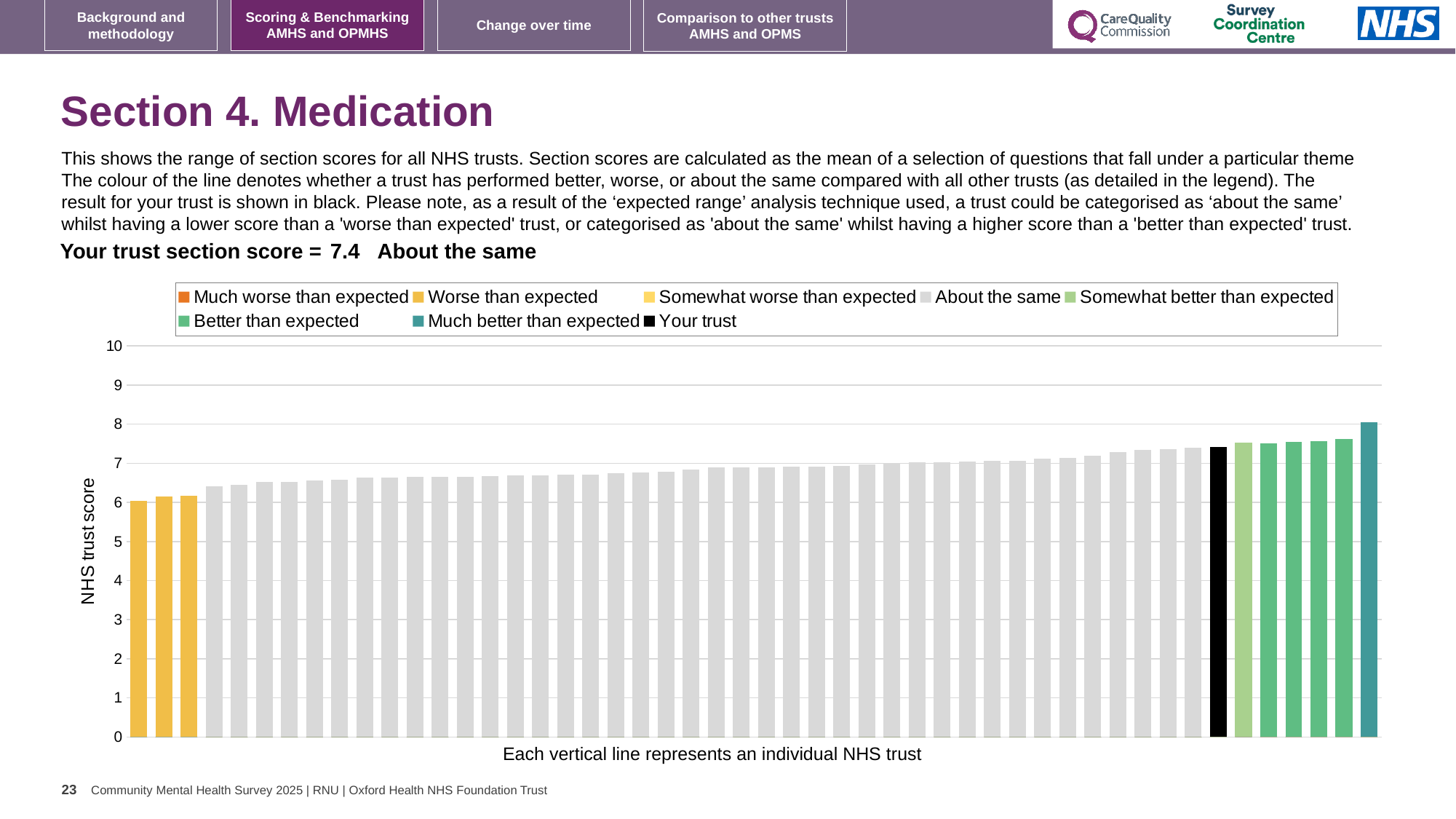
Do the bar values rise or fall from left to right along the x axis? rise How many bars are coloured as 'Worse than expected'? 3 How many bars are coloured as 'Much better than expected'? 1 Which category is your trust placed in for this section? About the same What is the label on the vertical axis of the chart? NHS trust score Which is larger: the value for your trust (black bar) or the value of the leftmost bar? your trust What kind of chart is shown on the slide? bar chart Is the value of the leftmost bar greater or less than 7? less What is the section score for your trust? 7.4 Is the value of the rightmost bar greater or less than 7? greater Is the value for your trust (the black bar) greater or less than 7? greater How many entries does the chart legend list? 8